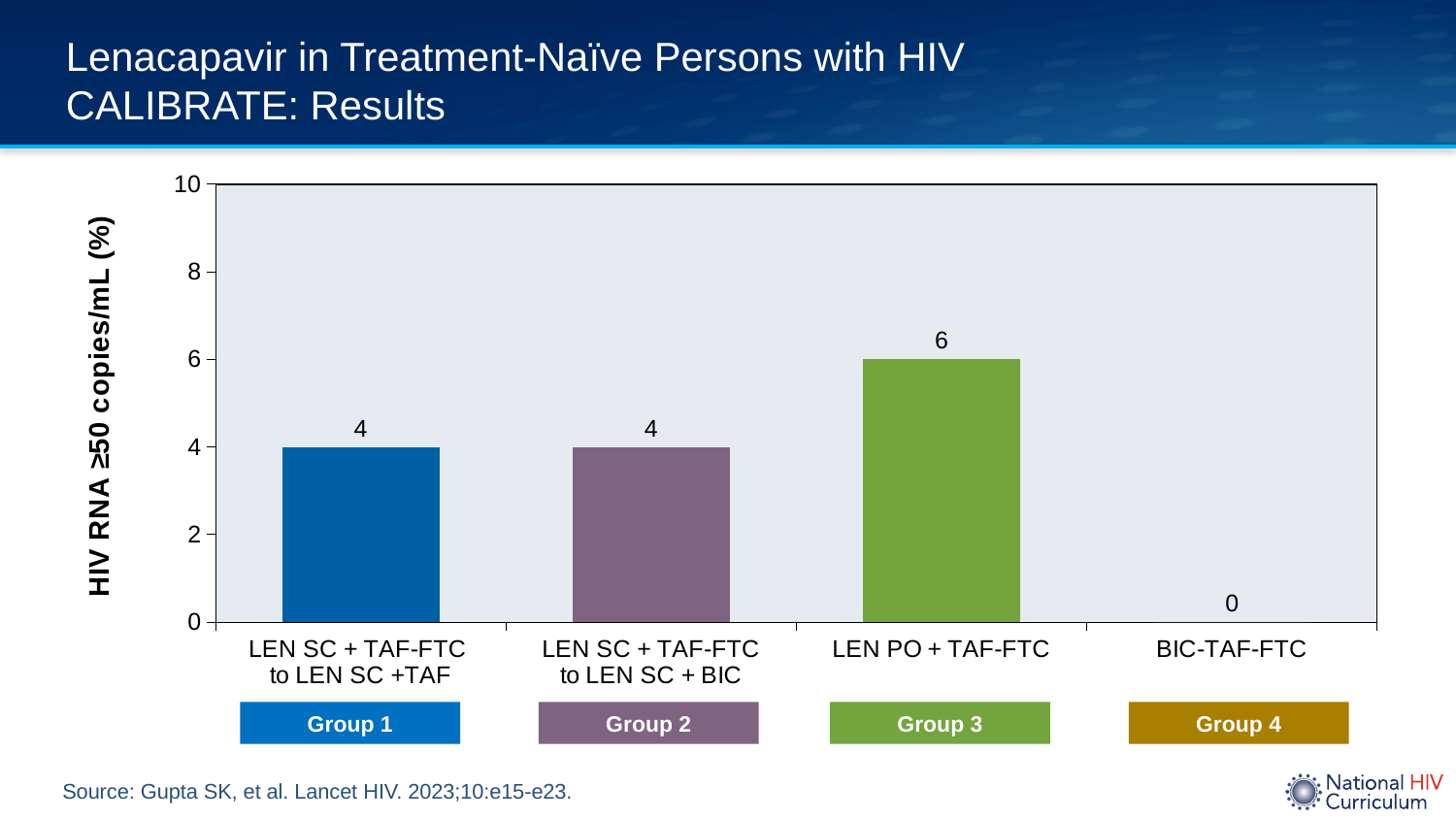
Which is larger, the value for Group 3 or the value for Group 2? Group 3 What is the value for Group 3 (LEN PO + TAF-FTC)? 6 Which group has the lowest percentage of HIV RNA ≥50 copies/mL? Group 4 (BIC-TAF-FTC) Which group has the highest percentage of HIV RNA ≥50 copies/mL? Group 3 (LEN PO + TAF-FTC) What is the label of the y-axis? HIV RNA ≥50 copies/mL (%) What is the difference between the values for Group 3 and Group 1? 2 What colour is the bar for Group 3? Green Is the value for Group 3 greater or less than 8? less What kind of chart is shown on the slide? Bar chart What is the value for Group 1 (LEN SC + TAF-FTC to LEN SC + TAF)? 4 What is the value for Group 4 (BIC-TAF-FTC)? 0 How many groups are shown on the chart? 4